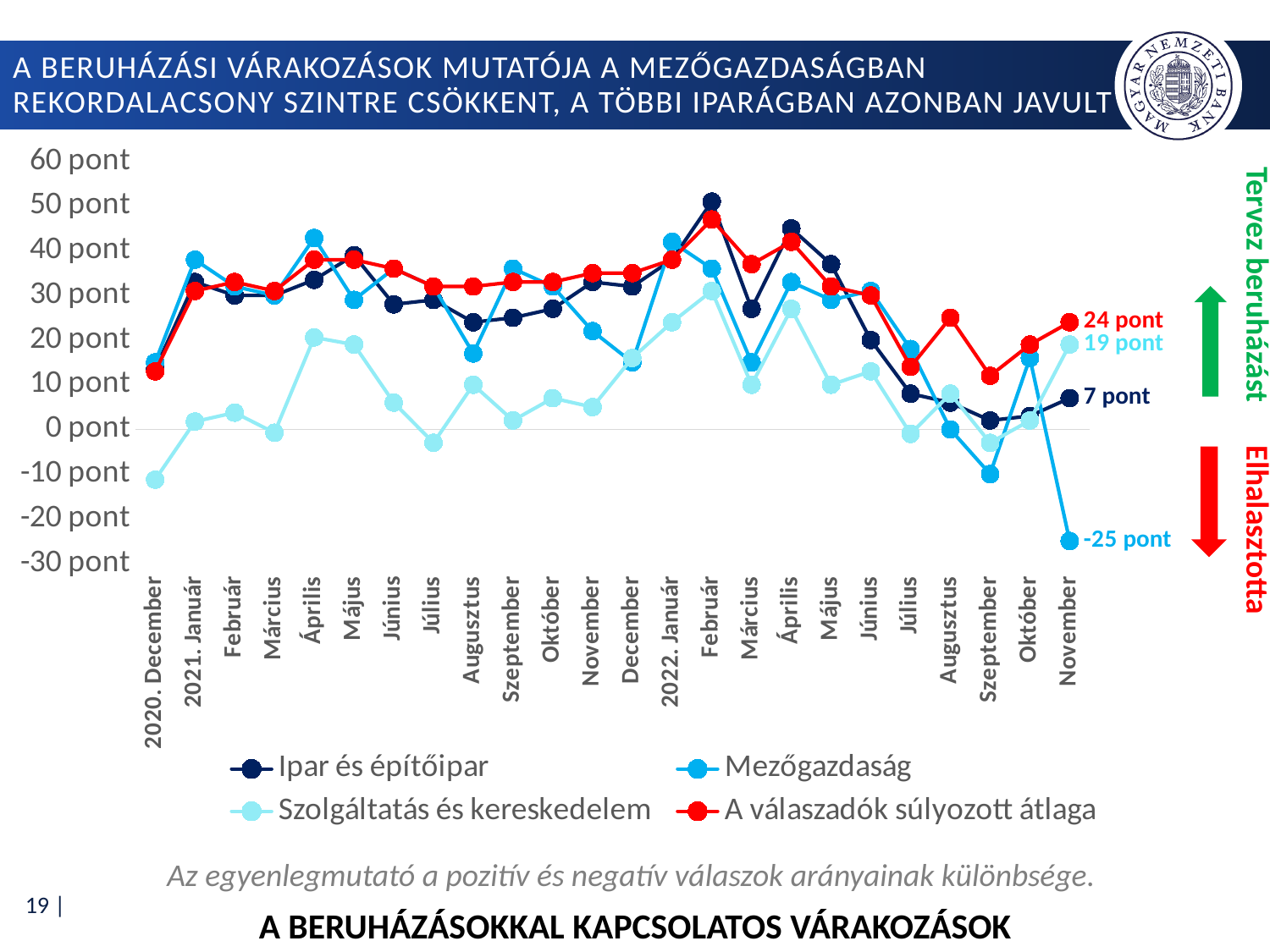
Which series has the lowest value in 2022 November? Mezőgazdaság How many months are shown on the x axis? 24 How many series does the legend list? 4 What is the value for Mezőgazdaság in 2022 November? -25 pont Is the value for Ipar és építőipar in 2022 Február greater or less than 40 pont? greater What is the difference between A válaszadók súlyozott átlaga and Ipar és építőipar in 2022 November? 17 pont What is the value for Szolgáltatás és kereskedelem in 2022 November? 19 pont Is the value for Szolgáltatás és kereskedelem in 2020 December greater or less than 0 pont? less What type of chart is shown on the slide? line chart Which series has the highest value in 2022 November? A válaszadók súlyozott átlaga What is the value for Ipar és építőipar in 2022 November? 7 pont What is the value for A válaszadók súlyozott átlaga in 2022 November? 24 pont